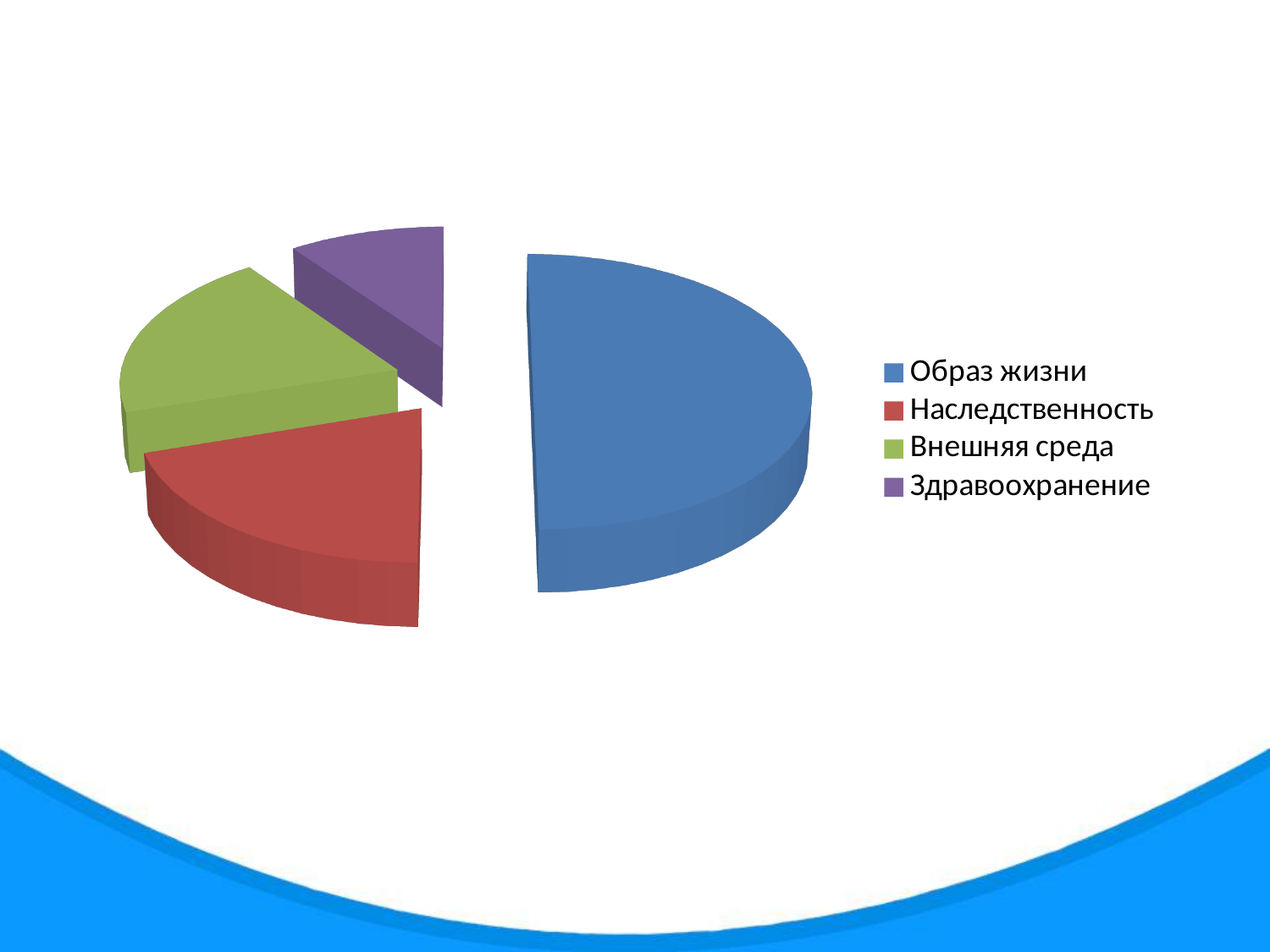
Which category has the smallest slice of the pie? Здравоохранение What colour is the slice for Образ жизни? blue Which category has the largest slice of the pie? Образ жизни Which slice is larger, Внешняя среда or Здравоохранение? Внешняя среда Which slice is larger, Образ жизни or Здравоохранение? Образ жизни How many slices does the pie chart have? 4 Which slice is larger, Наследственность or Здравоохранение? Наследственность How many entries does the legend list? 4 Which category is shown in purple in the legend? Здравоохранение What kind of chart is shown on the slide? pie chart